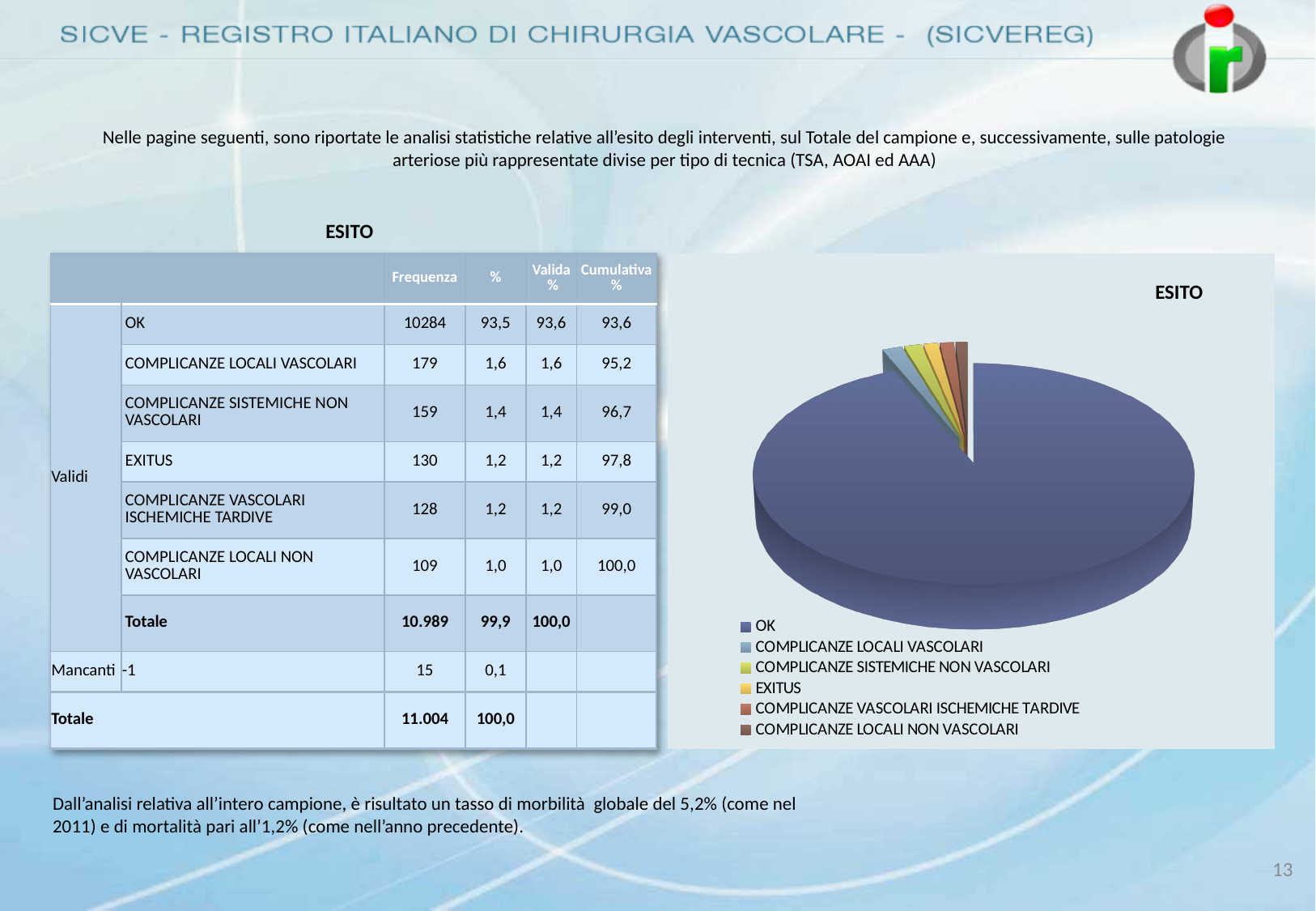
In the pie chart, which slice is larger: OK or COMPLICANZE LOCALI VASCOLARI? OK What kind of chart is shown on the slide? pie chart How many categories (slices) does the pie chart have? 6 What colour is the OK slice in the pie chart? blue In the pie chart, which slice is larger: OK or EXITUS? OK What is the title of the pie chart? ESITO Which category has the largest slice in the pie chart? OK How many entries does the pie chart's legend list? 6